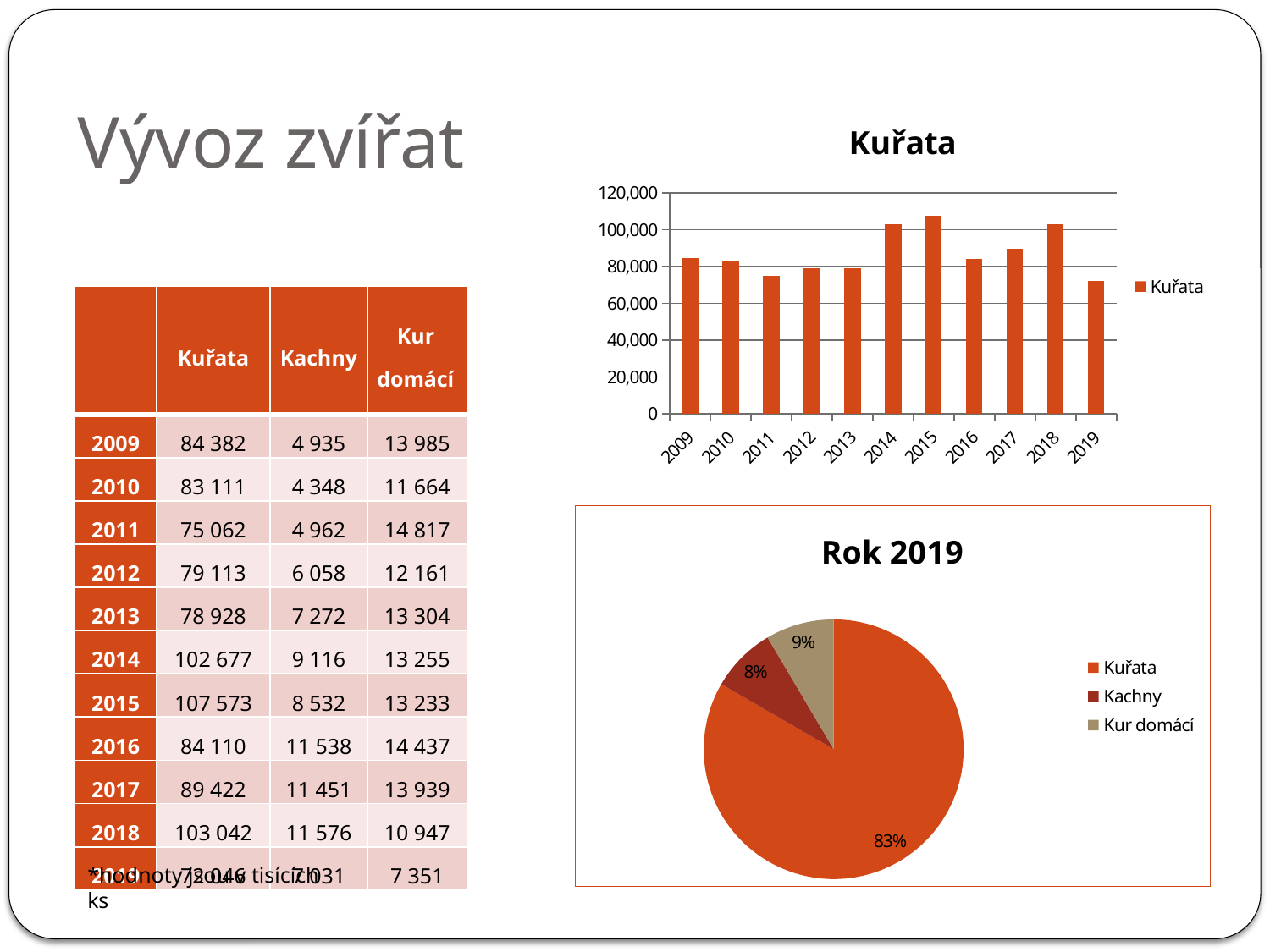
In the "Rok 2019" pie chart, what share does Kachny have? 8% In the "Kuřata" bar chart, which is larger, the value for 2015 or the value for 2016? 2015 In the "Kuřata" bar chart, is the value for 2014 greater or less than 100,000? greater In the "Kuřata" bar chart, which year has the highest bar? 2015 What kind of chart is the "Kuřata" chart at the top right of the slide? bar chart In the "Kuřata" bar chart, how many series does the legend list? 1 In the "Kuřata" bar chart, is the value for 2019 greater or less than 80,000? less In the "Kuřata" bar chart, is the value for 2011 greater or less than 80,000? less In the "Rok 2019" pie chart, what share does Kuřata have? 83% In the "Rok 2019" pie chart, which category has the smallest slice? Kachny In the "Kuřata" bar chart, how many years are shown on the x axis? 11 What kind of chart is the "Rok 2019" chart? pie chart